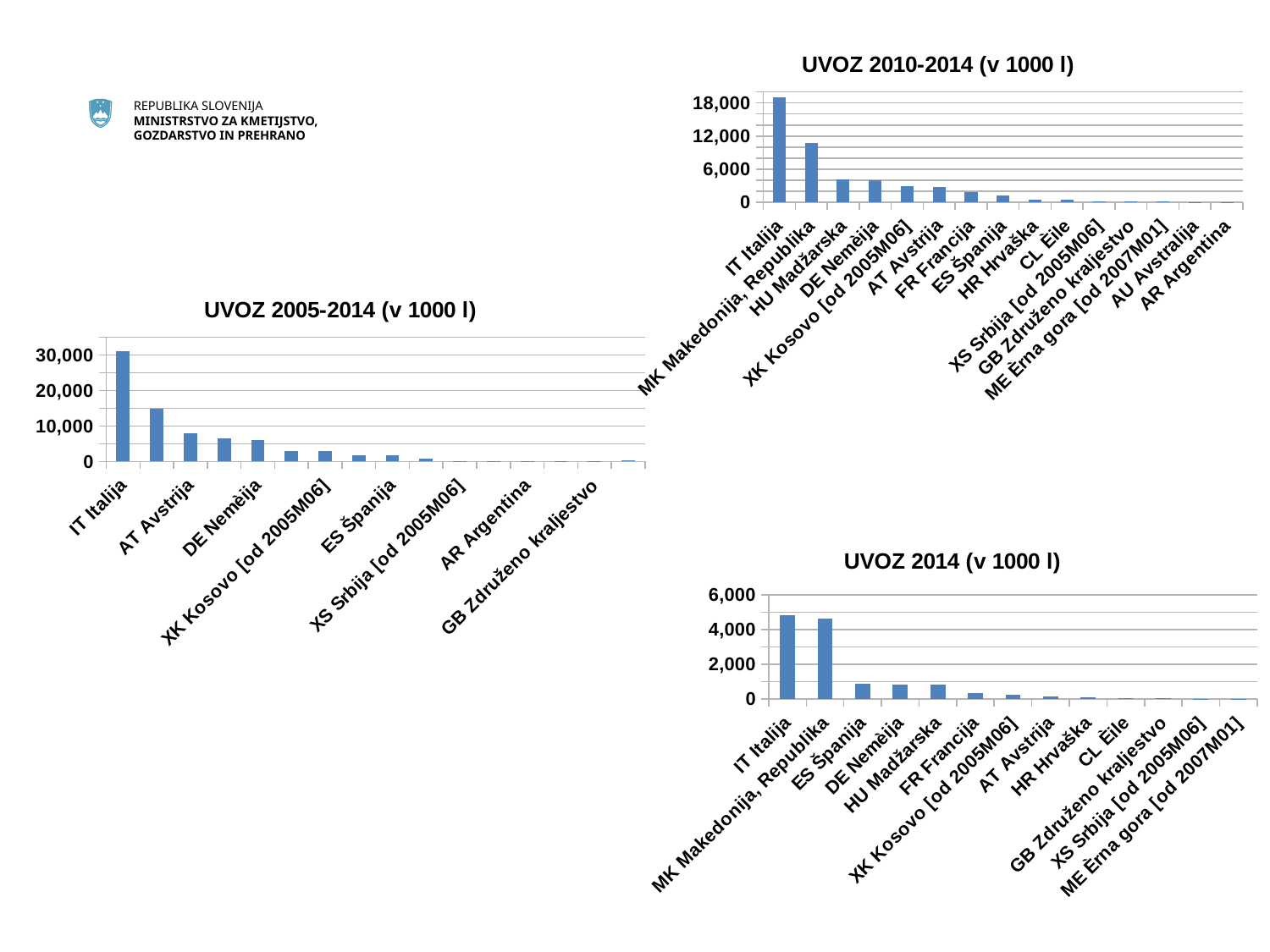
How many categories are shown in the chart "UVOZ 2010-2014 (v 1000 l)"? 15 In the chart "UVOZ 2010-2014 (v 1000 l)", which is larger, the value for IT Italija or the value for MK Makedonija, Republika? IT Italija In the chart "UVOZ 2005-2014 (v 1000 l)", which category has the highest value? IT Italija What kind of chart is "UVOZ 2005-2014 (v 1000 l)"? bar chart In the chart "UVOZ 2010-2014 (v 1000 l)", which category has the highest value? IT Italija In the chart "UVOZ 2014 (v 1000 l)", is the value for IT Italija greater or less than 4,000? greater How many categories are shown in the chart "UVOZ 2014 (v 1000 l)"? 13 In the chart "UVOZ 2010-2014 (v 1000 l)", is the value for MK Makedonija, Republika greater or less than 12,000? less In the chart "UVOZ 2005-2014 (v 1000 l)", do the values rise or fall from left to right along the x axis? fall In the chart "UVOZ 2005-2014 (v 1000 l)", is the value for AT Avstrija greater or less than 10,000? less